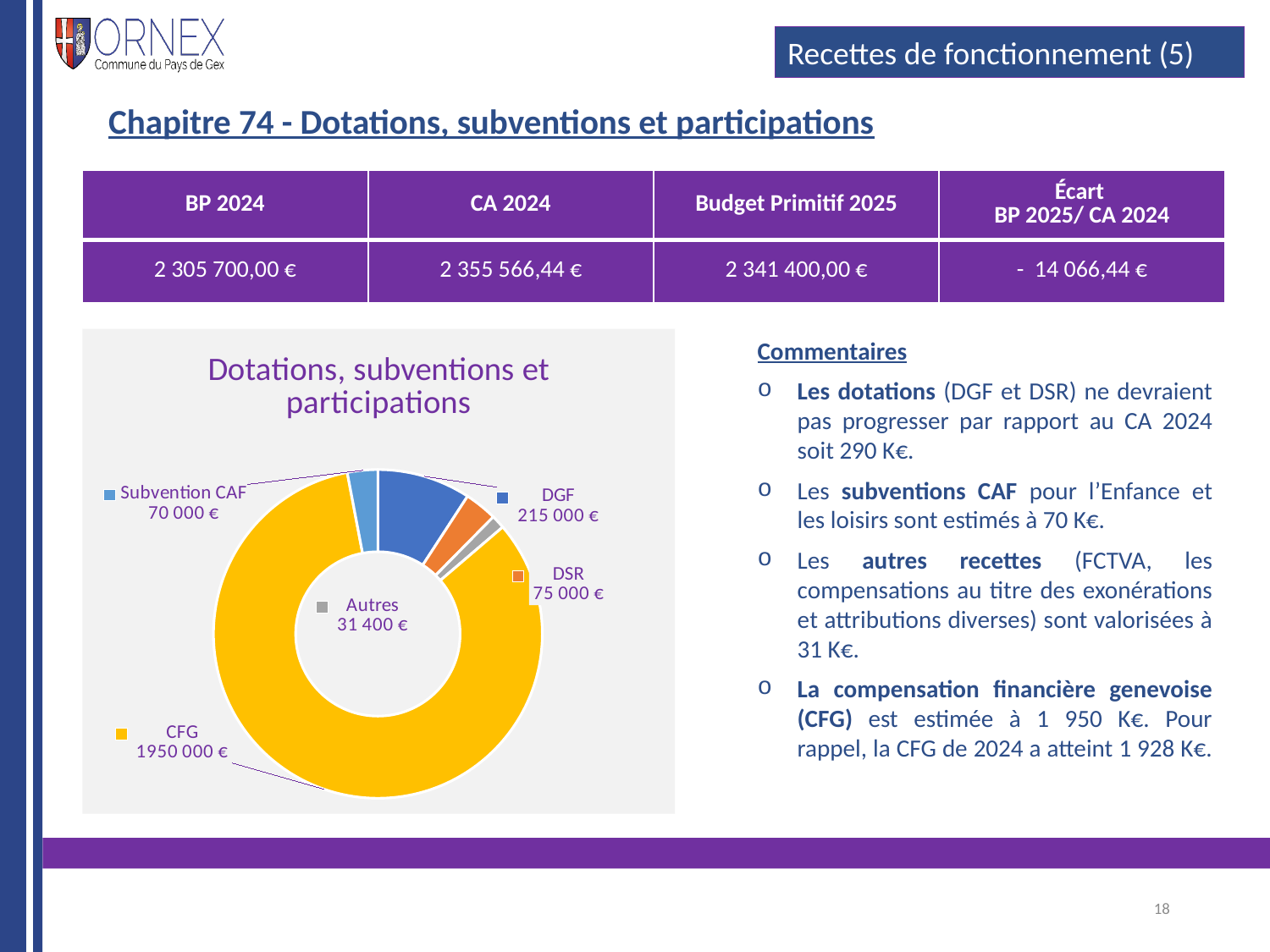
What is the difference between the DGF and DSR values in the doughnut chart? 140 000 € What kind of chart is shown on the slide? doughnut chart How many categories are shown in the doughnut chart? 5 What is the value for DGF in the doughnut chart? 215 000 € Which is larger in the doughnut chart, DSR or Subvention CAF? DSR What is the value for Autres in the doughnut chart? 31 400 € What is the value for Subvention CAF in the doughnut chart? 70 000 € Which category has the smallest value in the doughnut chart? Autres What is the total of all the values shown in the doughnut chart? 2 341 400 € What is the title of the chart on the slide? Dotations, subventions et participations What is the value for CFG in the doughnut chart? 1 950 000 € Which category has the largest value in the doughnut chart? CFG